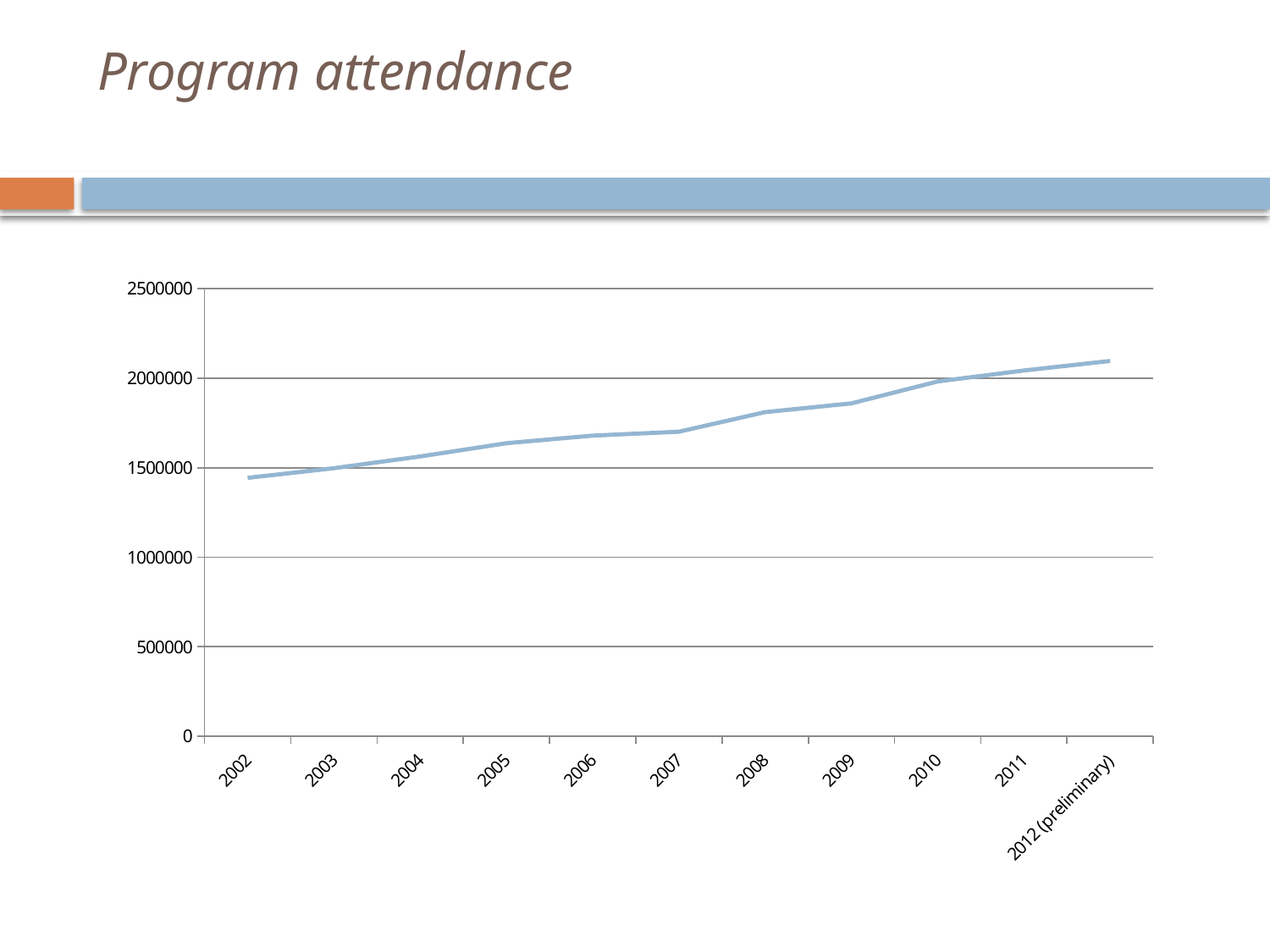
What is the title of the slide containing the chart? Program attendance What kind of chart is shown on the slide? line chart How many years (data points) are plotted along the x axis? 11 Is the value for 2005 greater or less than 1500000? greater Which year has the lowest program attendance? 2002 Do the attendance values rise or fall from 2002 to 2012 (preliminary)? rise Is the value for 2012 (preliminary) greater or less than 2000000? greater Which is larger, the value for 2002 or the value for 2011? 2011 Which is larger, the value for 2008 or the value for 2005? 2008 Is the value for 2007 greater or less than 2000000? less Which year has the highest program attendance? 2012 (preliminary)